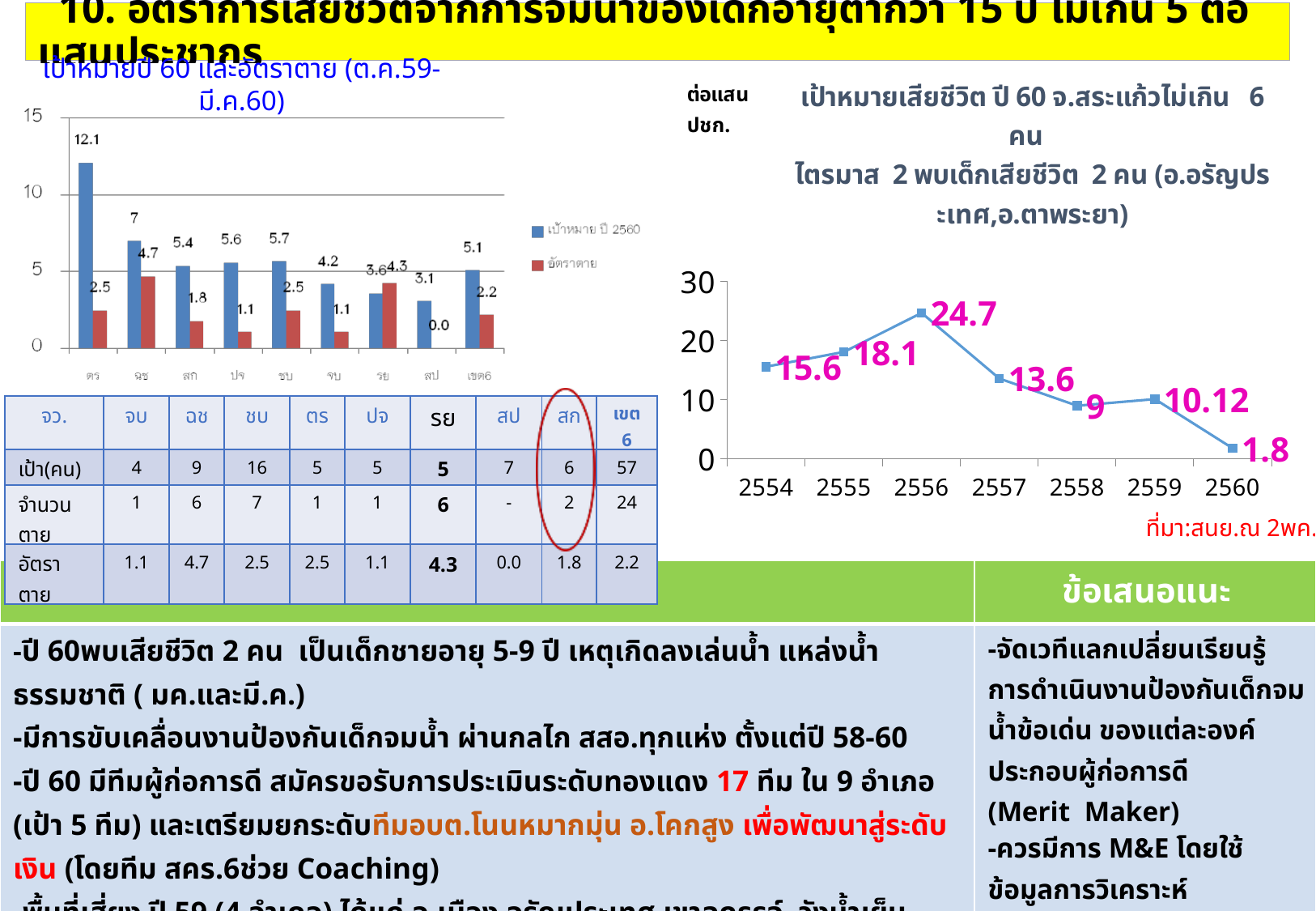
In the bar chart on the left, what is the เป้าหมาย ปี 2560 value for ตร? 12.1 In the line chart on the right, what is the value for 2556? 24.7 In the line chart on the right, do the values rise or fall from 2557 to 2558? fall In the line chart on the right, how many years are plotted on the x axis? 7 In the line chart on the right, what is the difference between the values for 2556 and 2557? 11.1 In the line chart on the right, what kind of chart is shown? line chart In the line chart on the right, which year has the highest value? 2556 In the bar chart on the left, is the อัตราตาย value for รย larger or smaller than the เป้าหมาย ปี 2560 value for รย? larger In the line chart on the right, which year has the lowest value? 2560 In the bar chart on the left, which category has the highest เป้าหมาย ปี 2560 value? ตร In the bar chart on the left, what is the อัตราตาย value for ฉช? 4.7 In the bar chart on the left, how many series does the legend list? 2